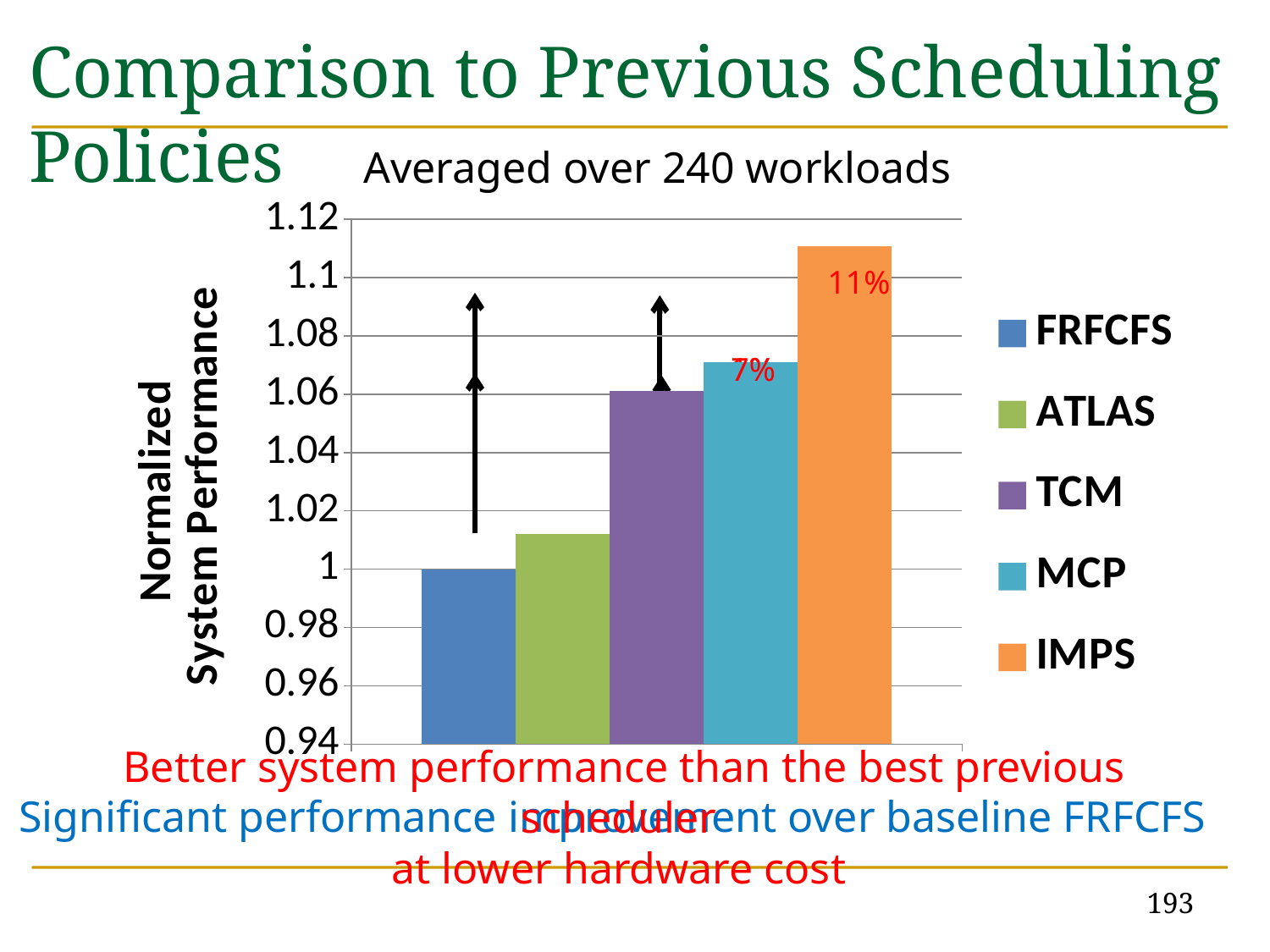
How many bars are plotted in the chart? 5 What is the normalized system performance value for FRFCFS? 1 Which has a higher normalized system performance, IMPS or TCM? IMPS How many series does the legend list? 5 Which has a higher normalized system performance, MCP or ATLAS? MCP What kind of chart is shown on the slide? bar chart Which scheduling policy has the highest normalized system performance? IMPS Is the value for TCM greater or less than 1.04? greater Do the bar values rise or fall from left to right across the chart? rise Is the value for ATLAS greater or less than 1.02? less What is the title shown above the chart? Averaged over 240 workloads Which scheduling policy has the lowest normalized system performance? FRFCFS